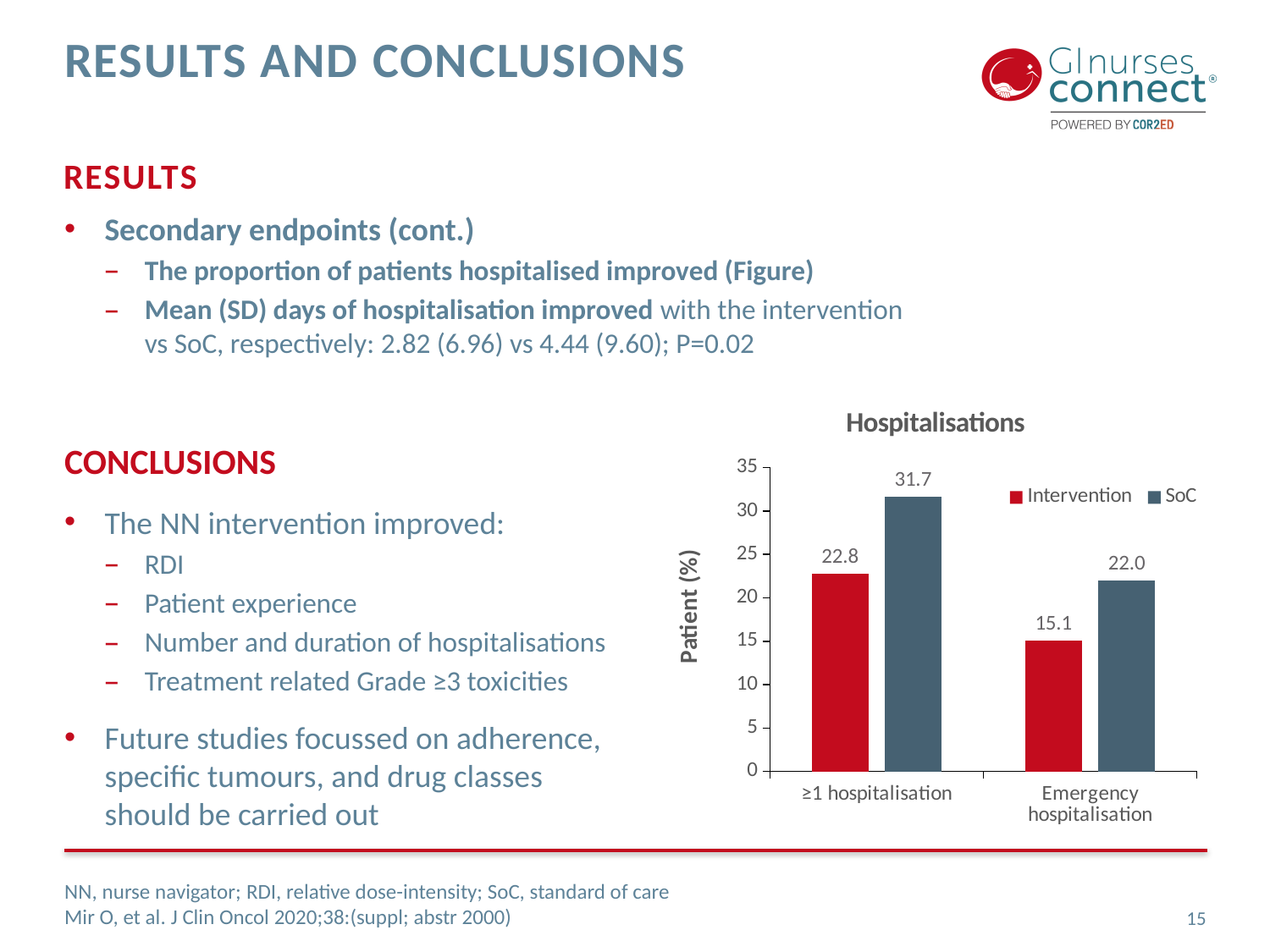
What is the difference between SoC and Intervention in the Emergency hospitalisation category? 6.9 What is the value for Intervention in the Emergency hospitalisation category? 15.1 What is the title of the chart? Hospitalisations What is the value for SoC in the ≥1 hospitalisation category? 31.7 How many categories are shown on the x axis? 2 What is the difference between SoC and Intervention in the ≥1 hospitalisation category? 8.9 What is the value for Intervention in the ≥1 hospitalisation category? 22.8 Which is larger for Emergency hospitalisation, Intervention or SoC? SoC Which bar has the highest value in the chart? SoC, ≥1 hospitalisation How many series does the legend list? 2 Which bar has the lowest value in the chart? Intervention, Emergency hospitalisation What is the value for SoC in the Emergency hospitalisation category? 22.0